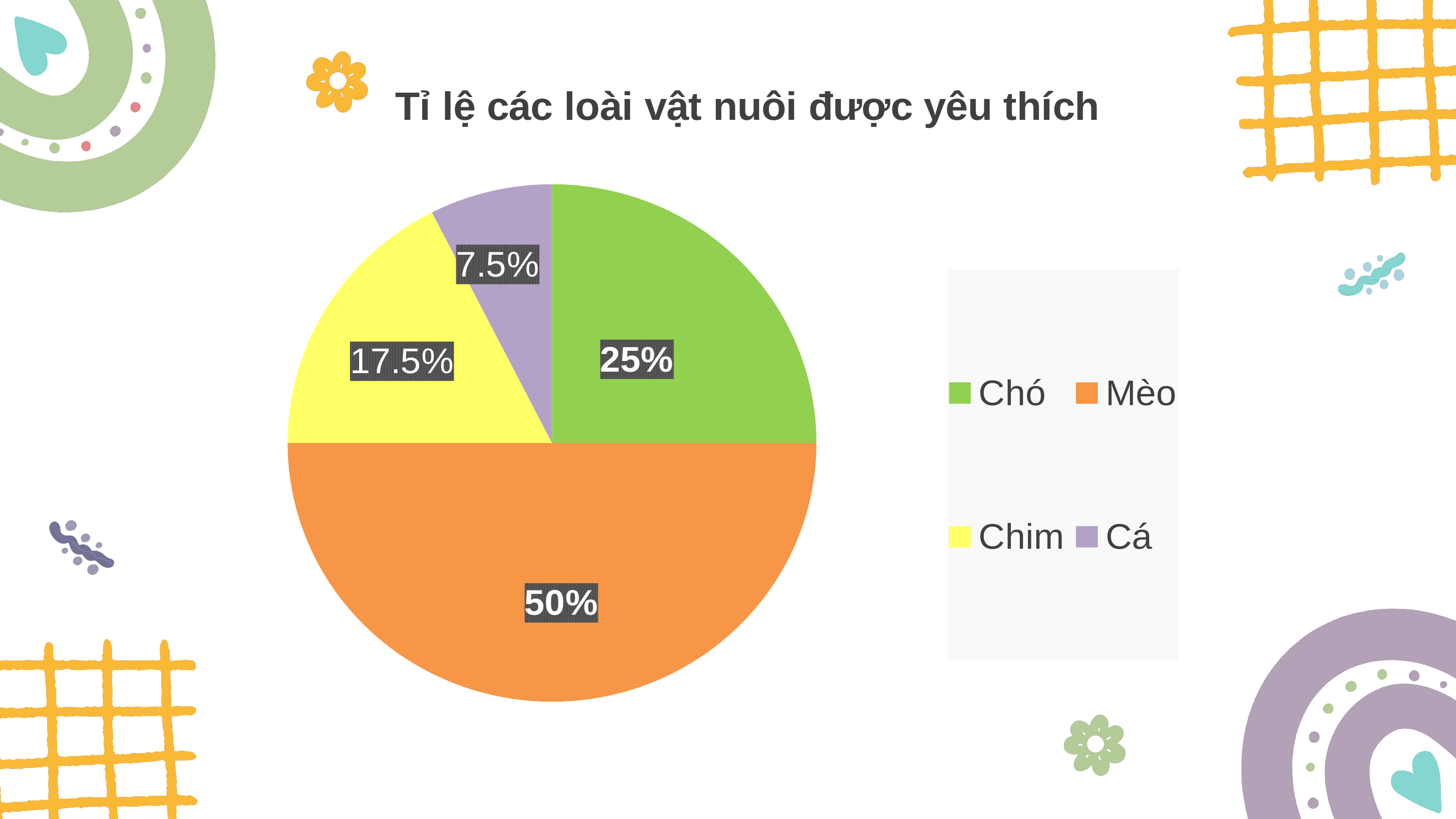
What is the difference in percentage points between Mèo and Chó? 25 How many categories does the legend list? 4 What kind of chart is shown on the slide? Pie chart Which category has the largest share of the pie? Mèo What is the title of the chart? Tỉ lệ các loài vật nuôi được yêu thích What percentage of the pie is Chim? 17.5% What is the difference in percentage points between Chim and Cá? 10 Which is larger, the share for Chó or the share for Chim? Chó What percentage of the pie is Mèo? 50% What percentage of the pie is Chó? 25% What percentage of the pie is Cá? 7.5% Which category has the smallest share of the pie? Cá